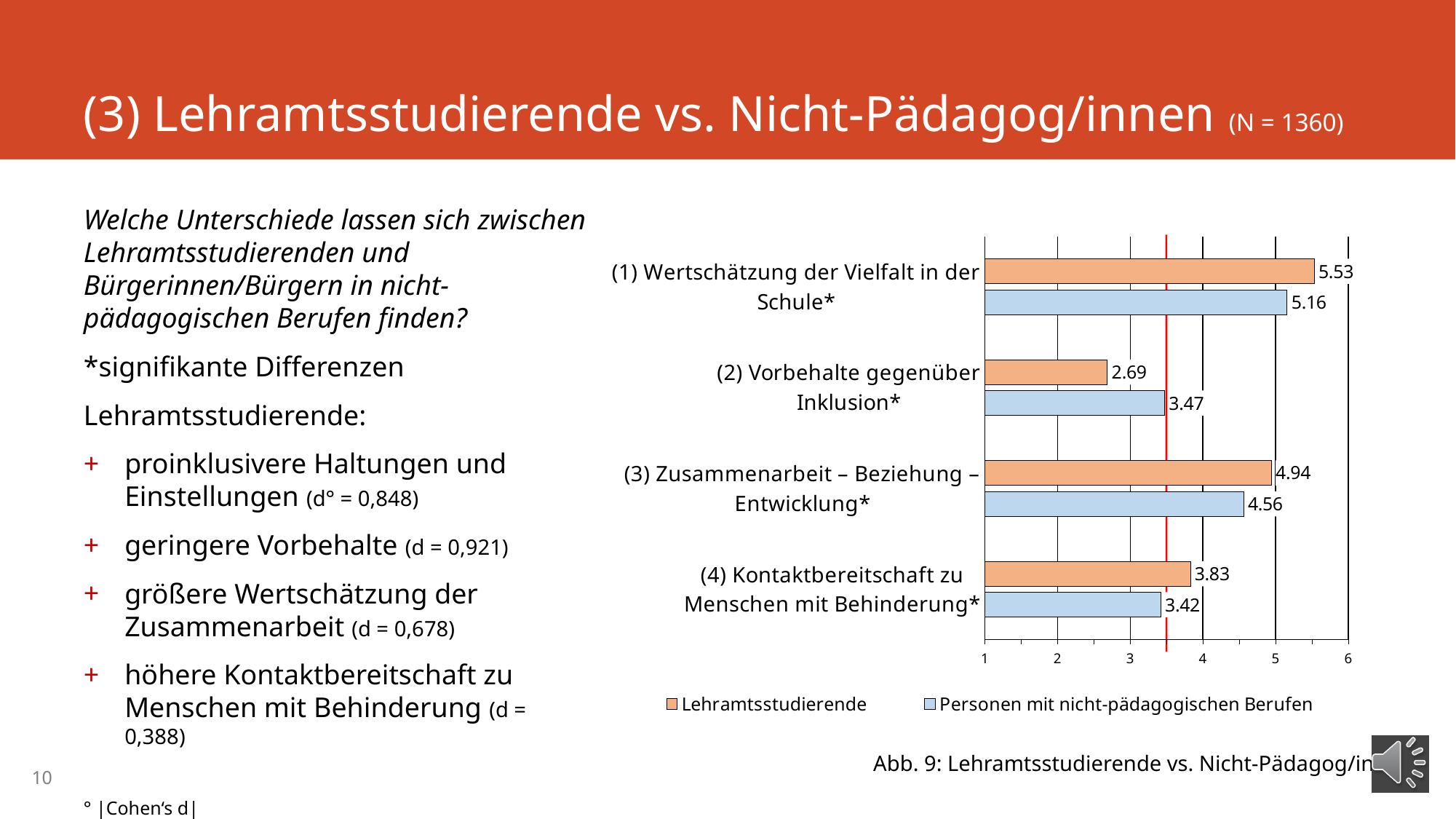
On '(2) Vorbehalte gegenüber Inklusion*', which series has the larger value? Personen mit nicht-pädagogischen Berufen Is the value for Personen mit nicht-pädagogischen Berufen on '(1) Wertschätzung der Vielfalt in der Schule*' greater or less than 5? greater Which category has the lowest value for Lehramtsstudierende? (2) Vorbehalte gegenüber Inklusion* How many series does the legend list? 2 How many categories are shown on the chart? 4 Which category has the highest value for Lehramtsstudierende? (1) Wertschätzung der Vielfalt in der Schule* What kind of chart is shown on the slide? bar chart What is the value for Lehramtsstudierende on '(1) Wertschätzung der Vielfalt in der Schule*'? 5.53 What is the difference between the two series on '(3) Zusammenarbeit – Beziehung – Entwicklung*'? 0.38 What is the value for Personen mit nicht-pädagogischen Berufen on '(2) Vorbehalte gegenüber Inklusion*'? 3.47 What is the value for Lehramtsstudierende on '(4) Kontaktbereitschaft zu Menschen mit Behinderung*'? 3.83 What is the caption of the chart? Abb. 9: Lehramtsstudierende vs. Nicht-Pädagog/innen